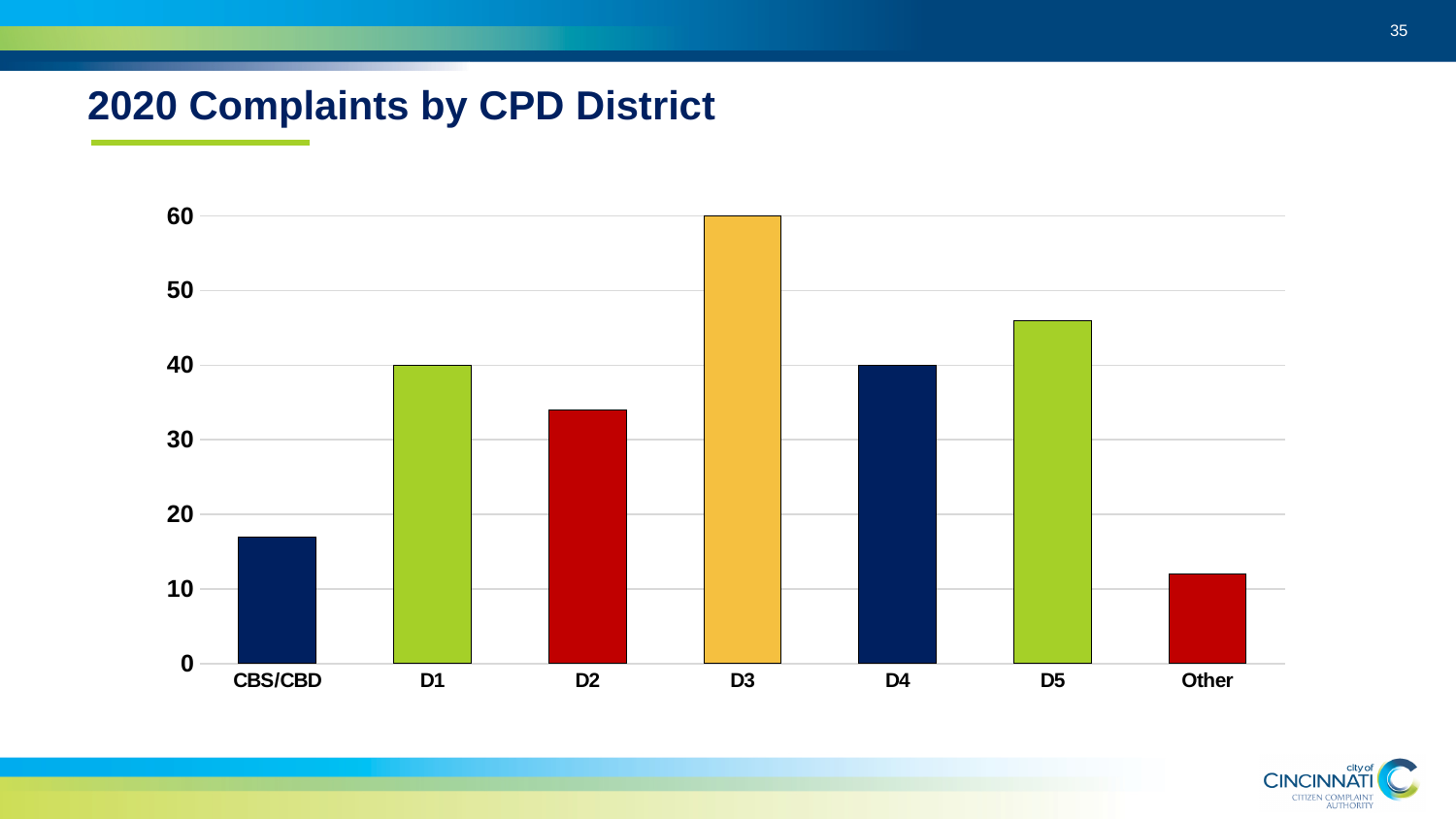
Which category has the lowest number of complaints? Other What type of chart is shown on the slide? bar chart What is the difference between the values for D3 and D1? 20 Which district has the highest number of complaints? D3 Which has more complaints, D5 or D2? D5 What is the value for D4? 40 What is the title of the chart? 2020 Complaints by CPD District What is the value for D1? 40 What is the value for D3? 60 Is the value for D5 greater or less than 40? greater How many districts (categories) are shown on the x axis? 7 Is the value for CBS/CBD greater or less than 20? less